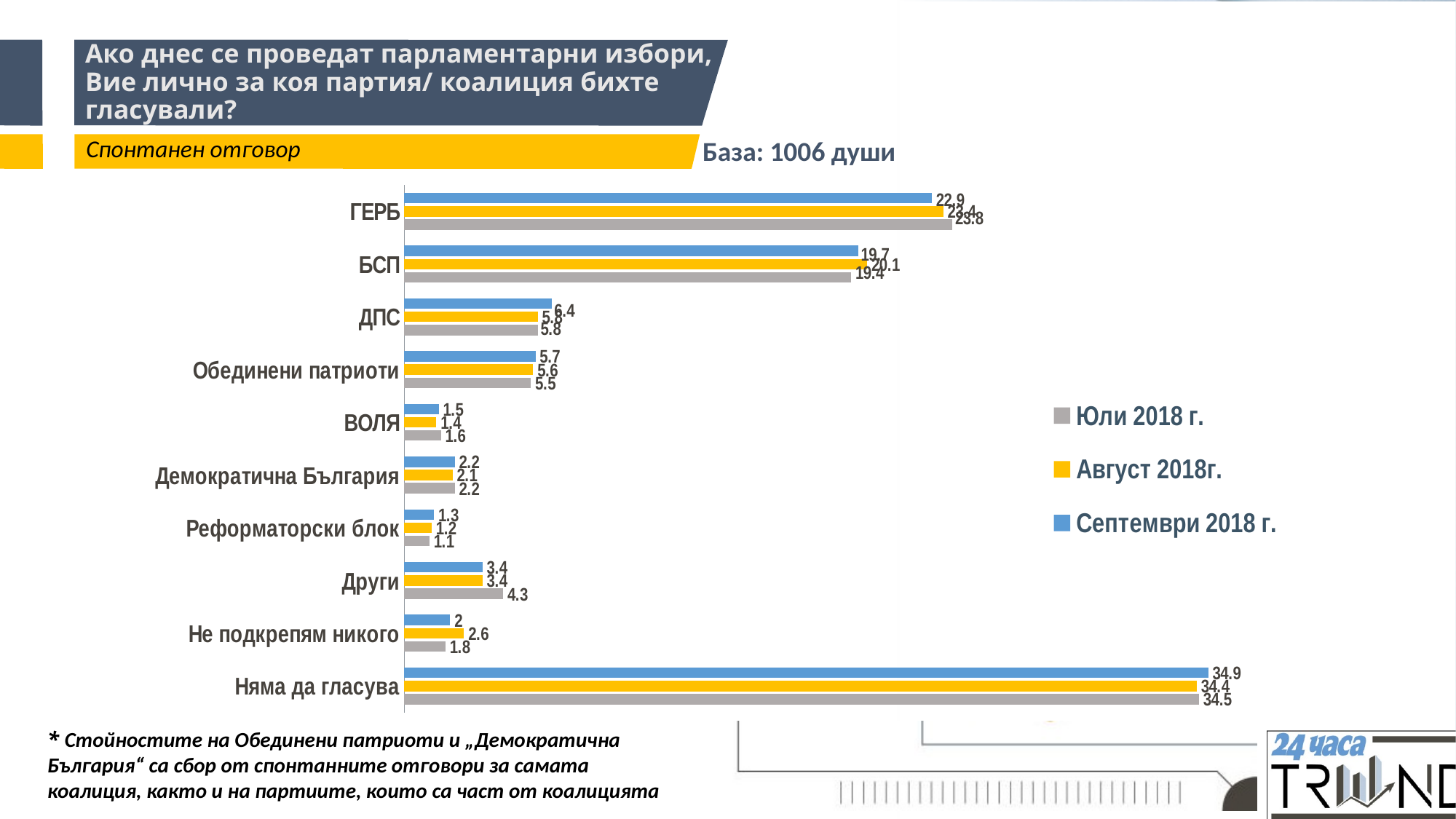
What kind of chart is shown on the slide? bar chart Which colour represents Август 2018г. in the legend? yellow Which category has the highest value in Септември 2018 г.? Няма да гласува Which is larger for Не подкрепям никого: the Август 2018г. value or the Юли 2018 г. value? Август 2018г. What is the value for Няма да гласува in Септември 2018 г.? 34.9 What is the difference between the Септември 2018 г. values for ГЕРБ and БСП? 3.2 What is the value for ГЕРБ in Септември 2018 г.? 22.9 What is the value for Други in Юли 2018 г.? 4.3 What is the value for БСП in Август 2018г.? 20.1 Which category has the lowest value in Юли 2018 г.? Реформаторски блок How many categories are shown on the chart? 10 How many series does the legend list? 3